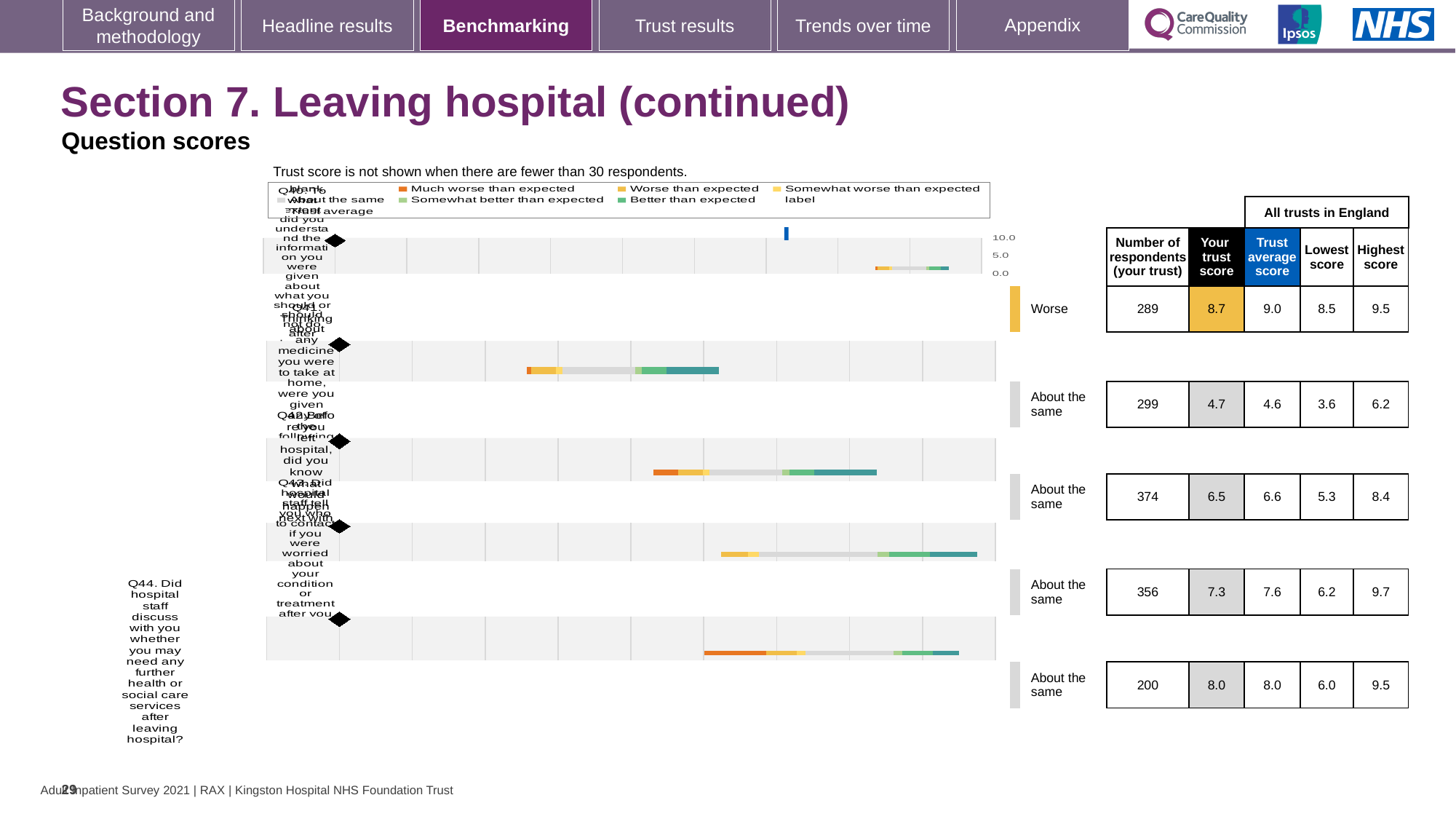
What is the trust average score for the first (top) question row? 9.0 What is the 'Your trust score' for the first (top) question row? 8.7 What kind of chart is used to show the question scores on this slide? Bar chart How many question rows are rated 'About the same' in the benchmarking chart? 4 What is the highest score across all trusts in England for the bottom row (Q44)? 9.5 For the first (top) question row, which is larger: the trust's own score or the trust average score? Trust average score What is the 'Your trust score' for the bottom row (Q44, about further health or social care services after leaving hospital)? 8.0 Which question row has the lowest 'Your trust score'? The second row (4.7) How many question rows are plotted in the benchmarking chart? 5 Which question row has the highest 'Your trust score'? The first (top) row (8.7) For the first (top) question row, what is the difference between the highest score (9.5) and the lowest score (8.5)? 1.0 What is the number of respondents for the bottom row (Q44)? 200